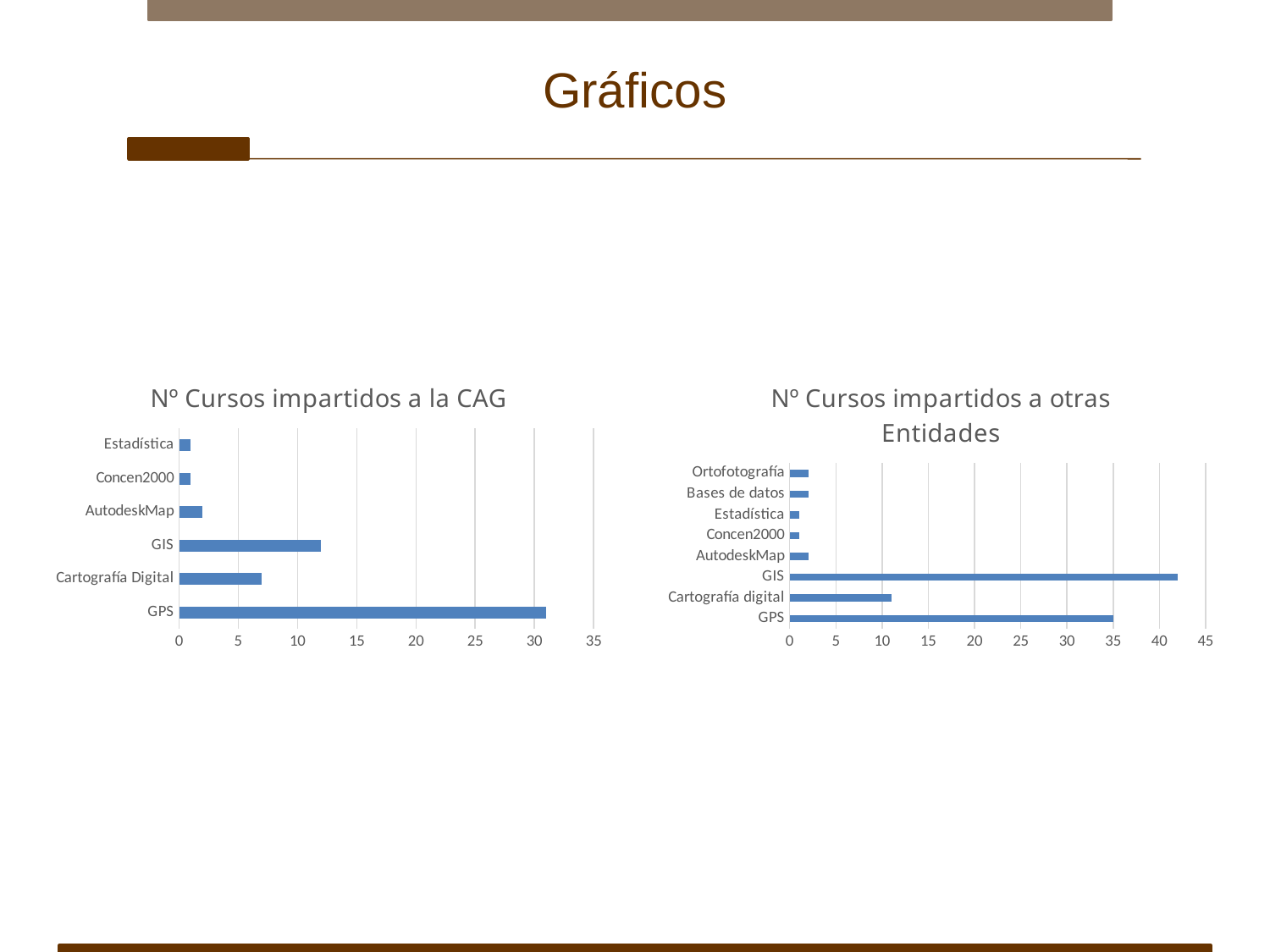
How many categories are shown in the chart titled 'Nº Cursos impartidos a la CAG'? 6 In the chart titled 'Nº Cursos impartidos a otras Entidades', is the value for Cartografía digital greater or less than 15? less In the chart titled 'Nº Cursos impartidos a otras Entidades', which category has the highest value? GIS In the chart titled 'Nº Cursos impartidos a la CAG', is the value for Cartografía Digital greater or less than 10? less In the chart titled 'Nº Cursos impartidos a la CAG', is the value for GPS greater or less than 30? greater In the chart titled 'Nº Cursos impartidos a la CAG', which category has the highest value? GPS How many categories are shown in the chart titled 'Nº Cursos impartidos a otras Entidades'? 8 What kind of chart is the chart titled 'Nº Cursos impartidos a otras Entidades'? Bar chart In the chart titled 'Nº Cursos impartidos a otras Entidades', which is larger, the value for GPS or the value for Cartografía digital? GPS In the chart titled 'Nº Cursos impartidos a la CAG', which is larger, the value for GIS or the value for Cartografía Digital? GIS